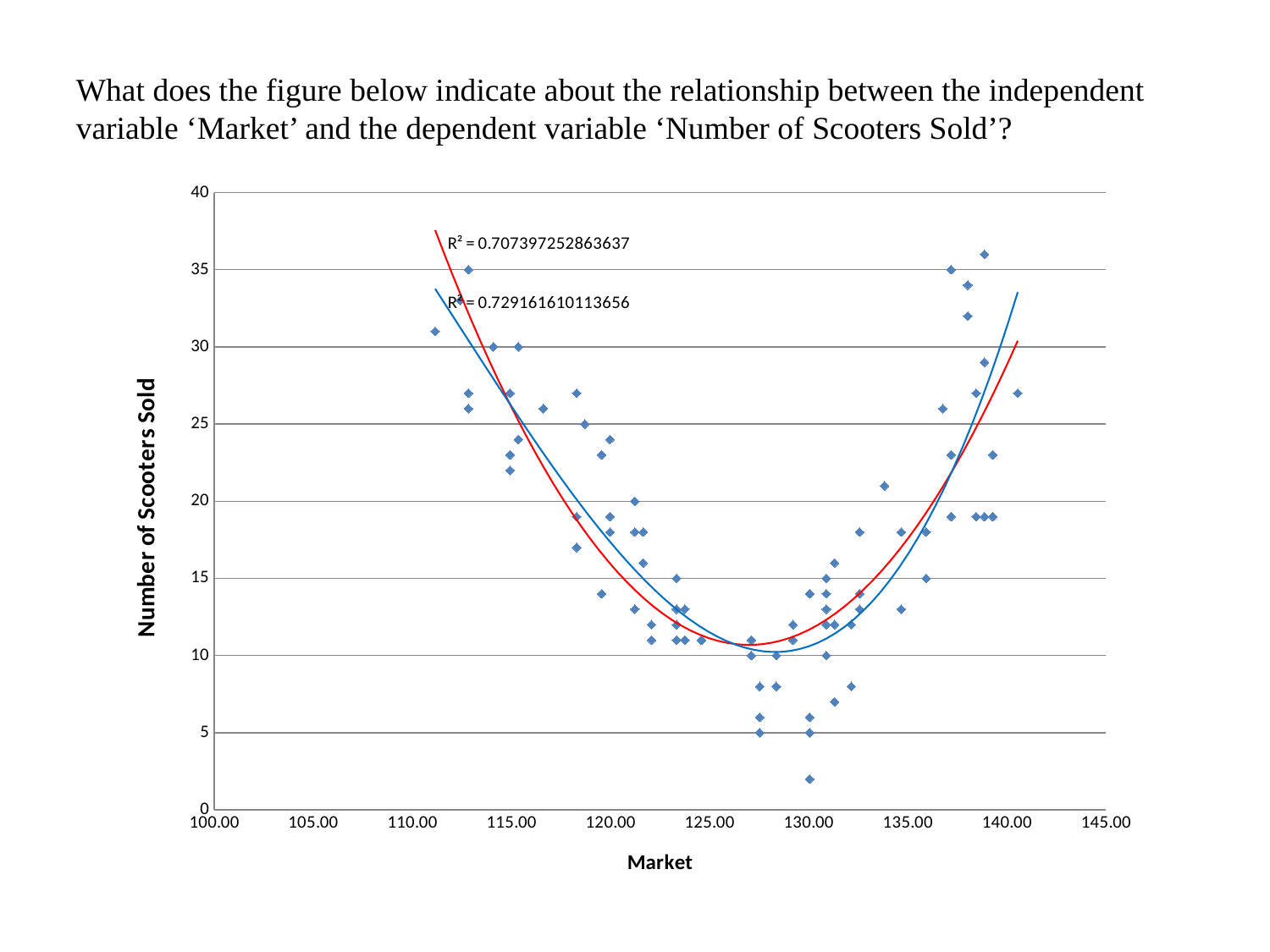
What R² value is printed for the blue trendline on the chart? R² = 0.729161610113656 What is the title of the y axis of the chart? Number of Scooters Sold What R² value is printed for the red trendline on the chart? R² = 0.707397252863637 What is the maximum value shown on the y axis of the chart? 40 How many trendlines are drawn on the chart? 2 Is the lowest plotted point on the chart greater or less than 5 scooters sold? less Do the plotted values fall and then rise, or rise and then fall, as Market increases along the x axis? Fall and then rise Is the highest plotted point on the chart greater or less than 30 scooters sold? greater Which trendline has the higher R² value, the red one or the blue one? The blue one What is the title of the x axis of the chart? Market What kind of chart is shown on the slide? Scatter chart